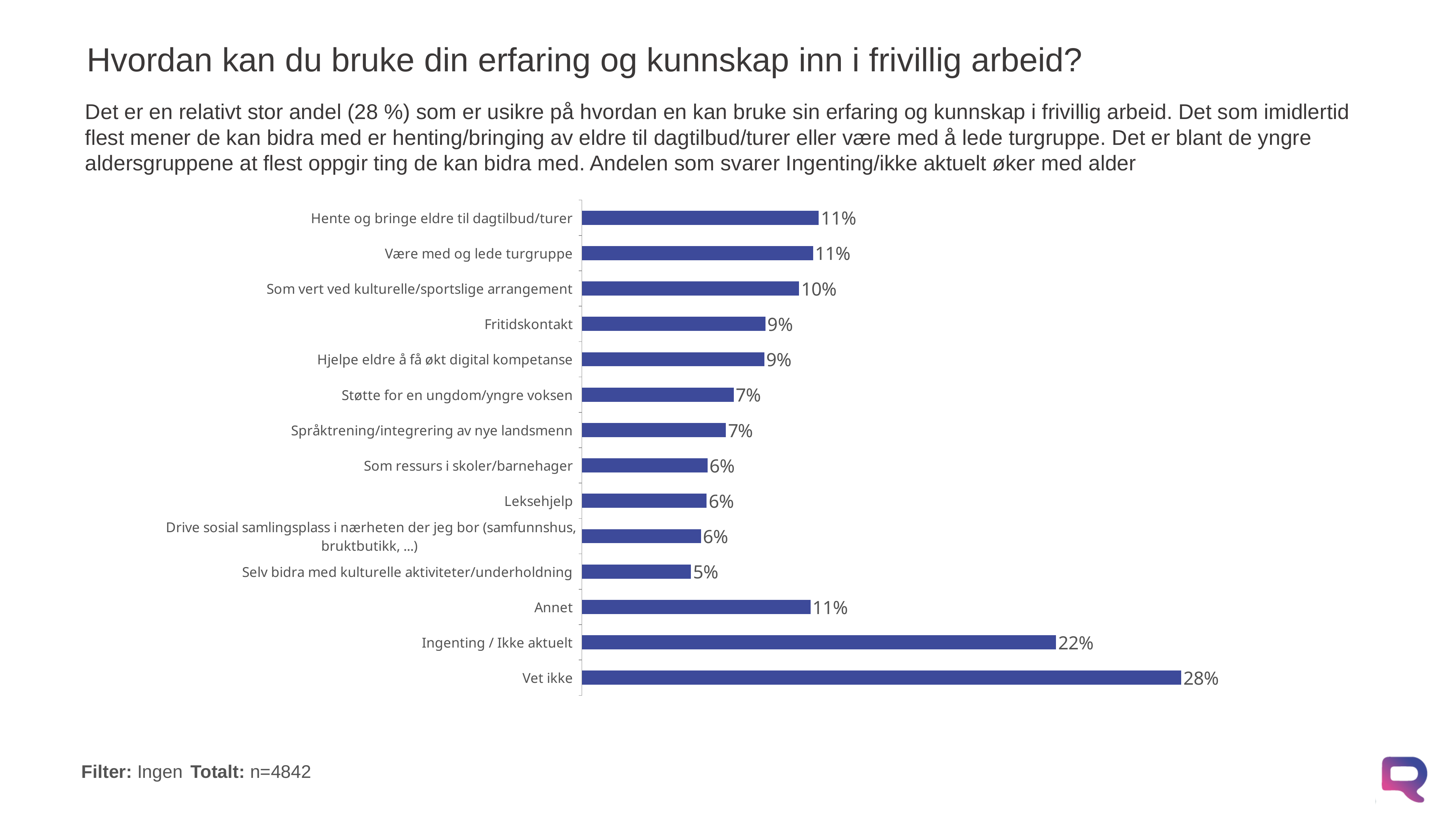
What is the difference between the values for "Vet ikke" and "Ingenting / Ikke aktuelt"? 6% What is the difference between the values for "Hente og bringe eldre til dagtilbud/turer" and "Støtte for en ungdom/yngre voksen"? 4% What is the value for "Ingenting / Ikke aktuelt"? 22% Which category has the lowest value? Selv bidra med kulturelle aktiviteter/underholdning What is the value for "Vet ikke"? 28% Which category has the highest value? Vet ikke Which is larger: the value for "Annet" or the value for "Leksehjelp"? Annet How many categories are shown in the chart? 14 What kind of chart is shown on the slide? Bar chart What is the value for "Selv bidra med kulturelle aktiviteter/underholdning"? 5% What is the value for "Som vert ved kulturelle/sportslige arrangement"? 10% What is the value for "Fritidskontakt"? 9%